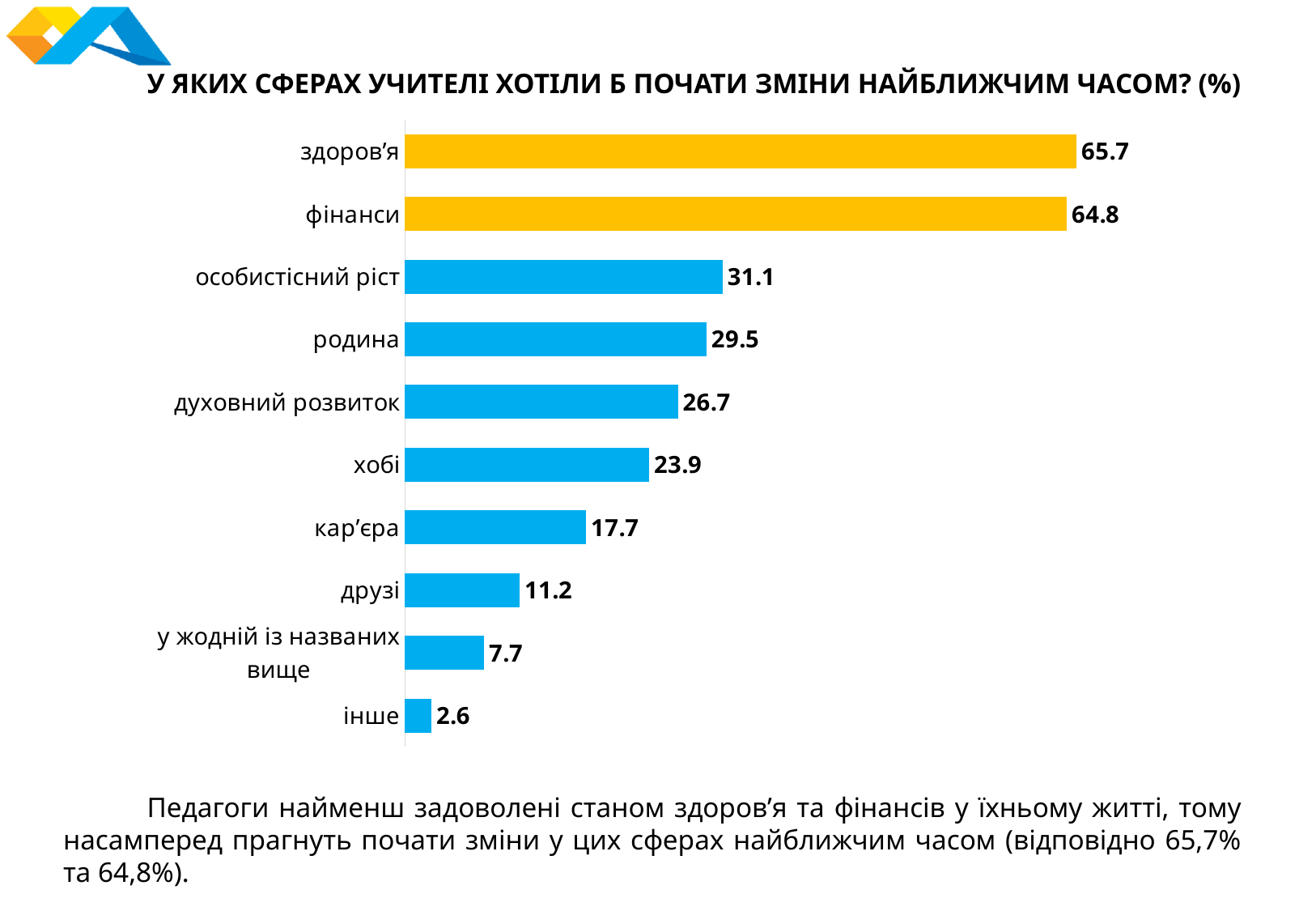
What is the value for у жодній із названих вище? 7.7 What is the difference between the values for особистісний ріст and родина? 1.6 What kind of chart is shown on the slide? bar chart How many categories are shown in the chart? 10 Which is larger, the value for хобі or the value for друзі? хобі What is the total of the values for здоров’я and фінанси? 130.5 What is the value for здоров’я? 65.7 Which category has the lowest value? інше Which two categories are shown with yellow bars instead of blue? здоров’я and фінанси Which category has the highest value? здоров’я What is the value for кар’єра? 17.7 What is the difference between the values for здоров’я and фінанси? 0.9